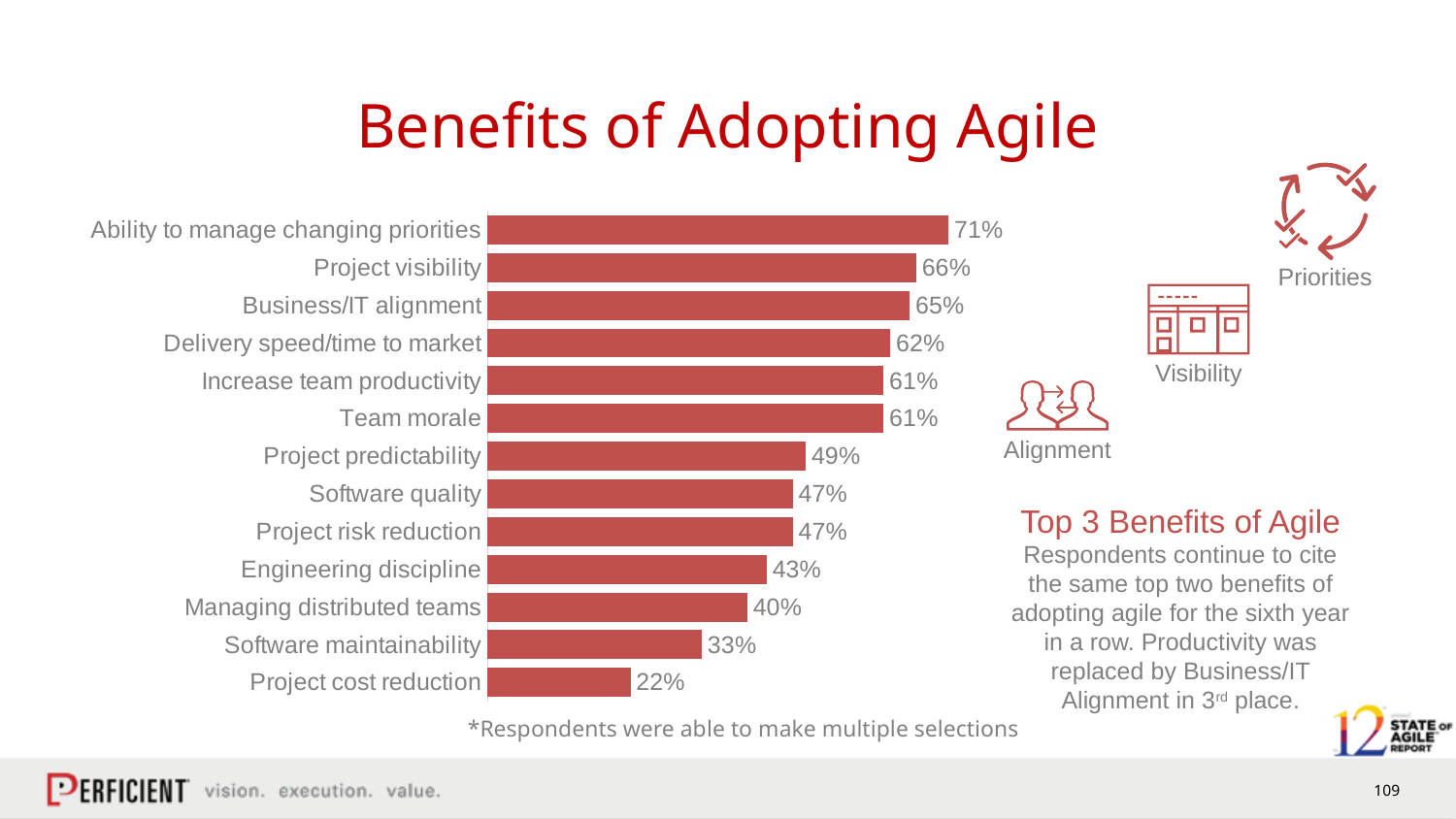
Which two benefits share the same value of 61%? Increase team productivity and Team morale Which benefit has the lowest percentage in the chart? Project cost reduction What is the value shown for 'Project visibility'? 66% What percentage is shown for 'Software maintainability'? 33% What is the difference in percentage points between 'Ability to manage changing priorities' and 'Project cost reduction'? 49 What type of chart is used on this slide? Bar chart Which benefit has the highest percentage in the chart? Ability to manage changing priorities What is the title of the slide containing the chart? Benefits of Adopting Agile Which has a higher value: 'Project predictability' or 'Managing distributed teams'? Project predictability What percentage of respondents cited 'Ability to manage changing priorities' as a benefit of adopting agile? 71% How many benefit categories are shown in the chart? 13 What is the difference in percentage points between 'Business/IT alignment' and 'Engineering discipline'? 22